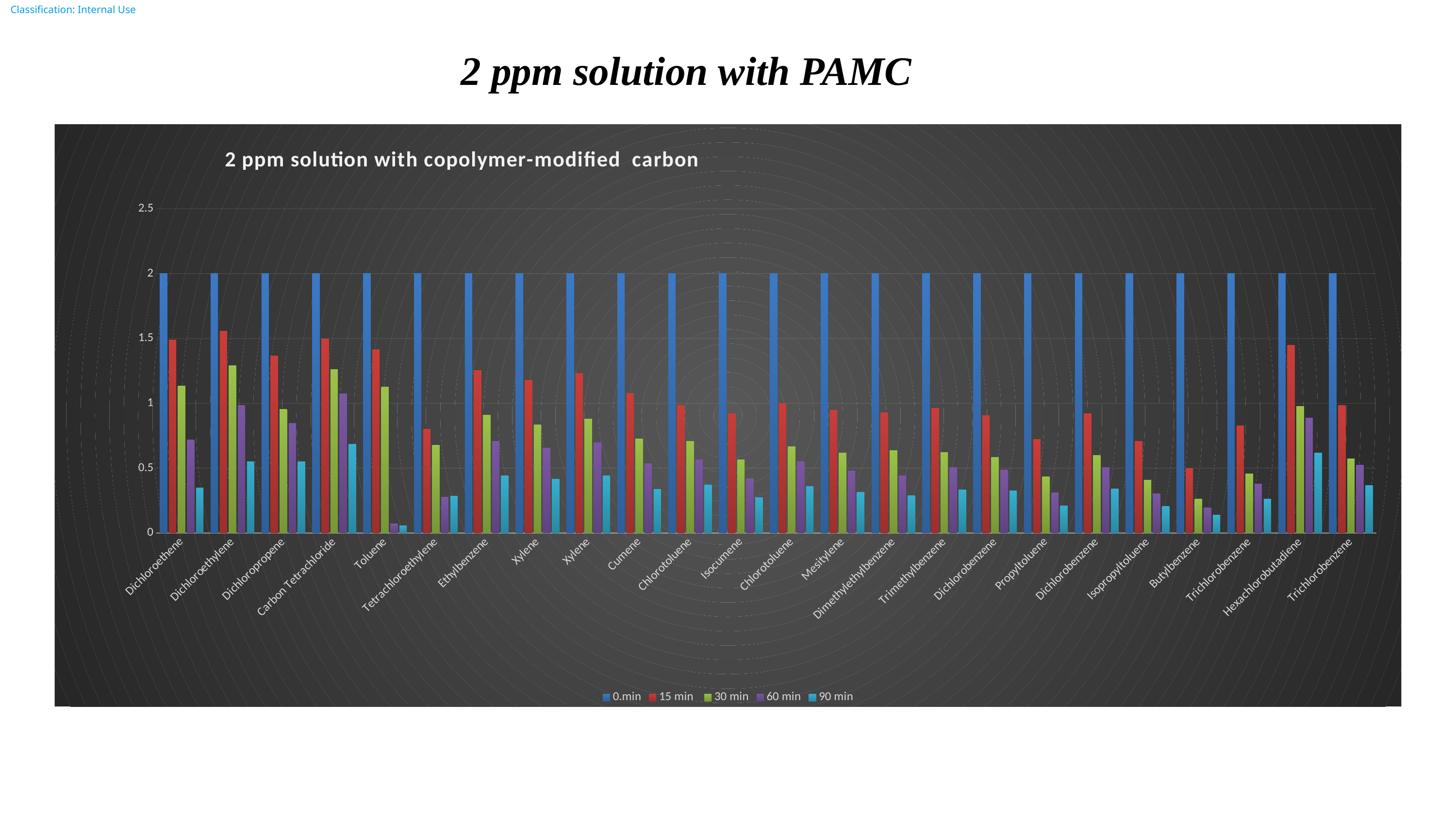
Is the 60 min value for Toluene greater or less than 0.5? less What is the title shown inside the chart area? 2 ppm solution with copolymer-modified carbon For Dichloroethene, do the values rise or fall from the 0.min series to the 90 min series? Fall What is the value of the 0.min series for Toluene? 2 What is the value of the 0.min series for Hexachlorobutadiene? 2 Which has the larger 15 min value, Dichloroethylene or Butylbenzene? Dichloroethylene What kind of chart is shown on the slide? Bar chart Is the 30 min value for Dichloroethylene greater or less than 1? greater How many categories are plotted along the x axis of the chart? 24 How many series does the chart legend list? 5 Is the 15 min value for Tetrachloroethylene greater or less than 1? less